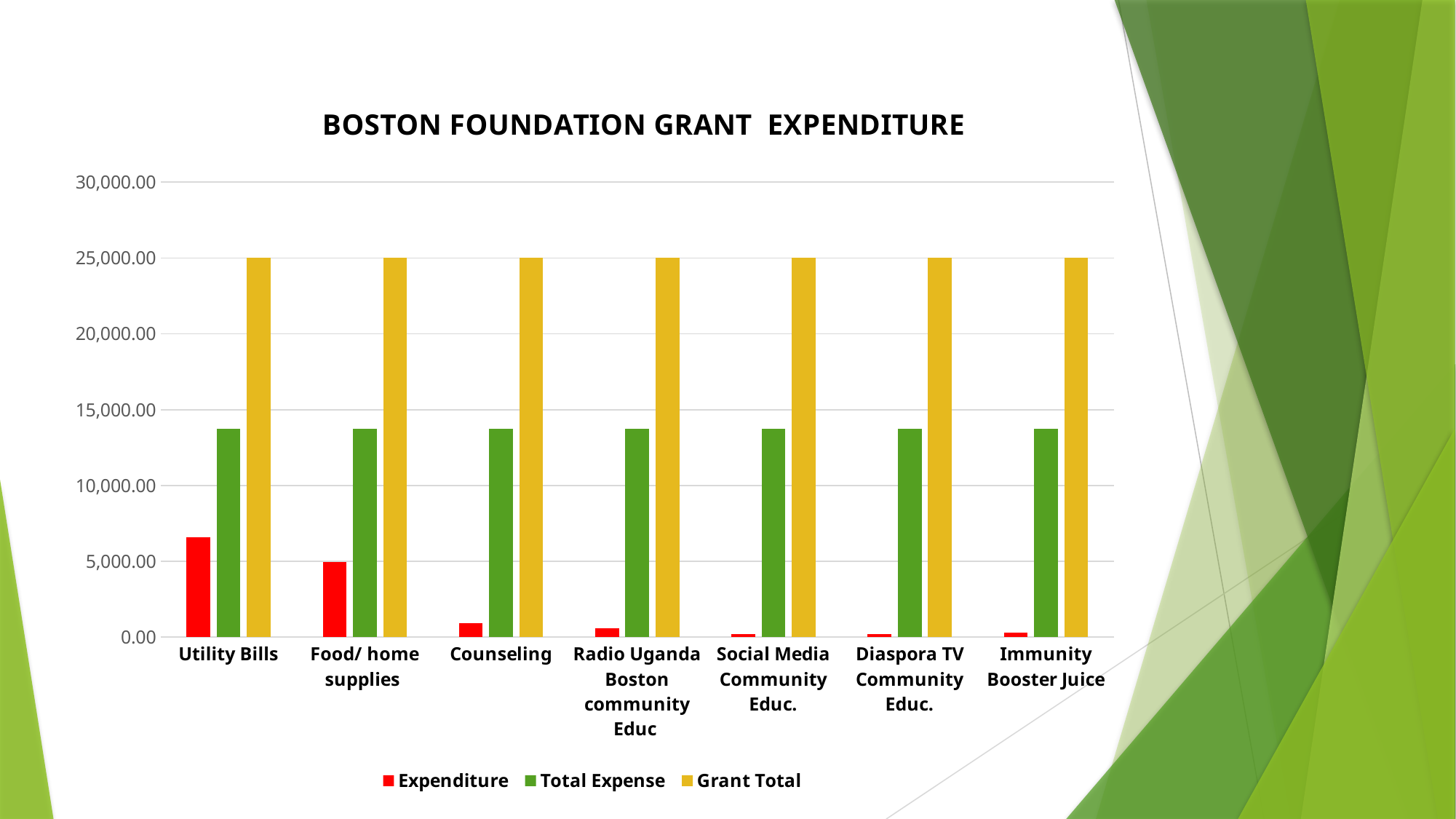
What is the Grant Total value for Immunity Booster Juice? 25,000.00 What is the Grant Total value for Utility Bills? 25,000.00 Is the Total Expense for Counseling greater or less than 15,000.00? less Which category has the highest Expenditure? Utility Bills Is the Expenditure for Utility Bills greater or less than 5,000.00? greater Is the Total Expense for Radio Uganda Boston community Educ greater or less than 10,000.00? greater Which has the larger Expenditure, Utility Bills or Counseling? Utility Bills What type of chart is shown on the slide? Bar chart How many categories are shown along the x axis of the chart? 7 What is the title of the chart? BOSTON FOUNDATION GRANT EXPENDITURE How many series does the chart's legend list? 3